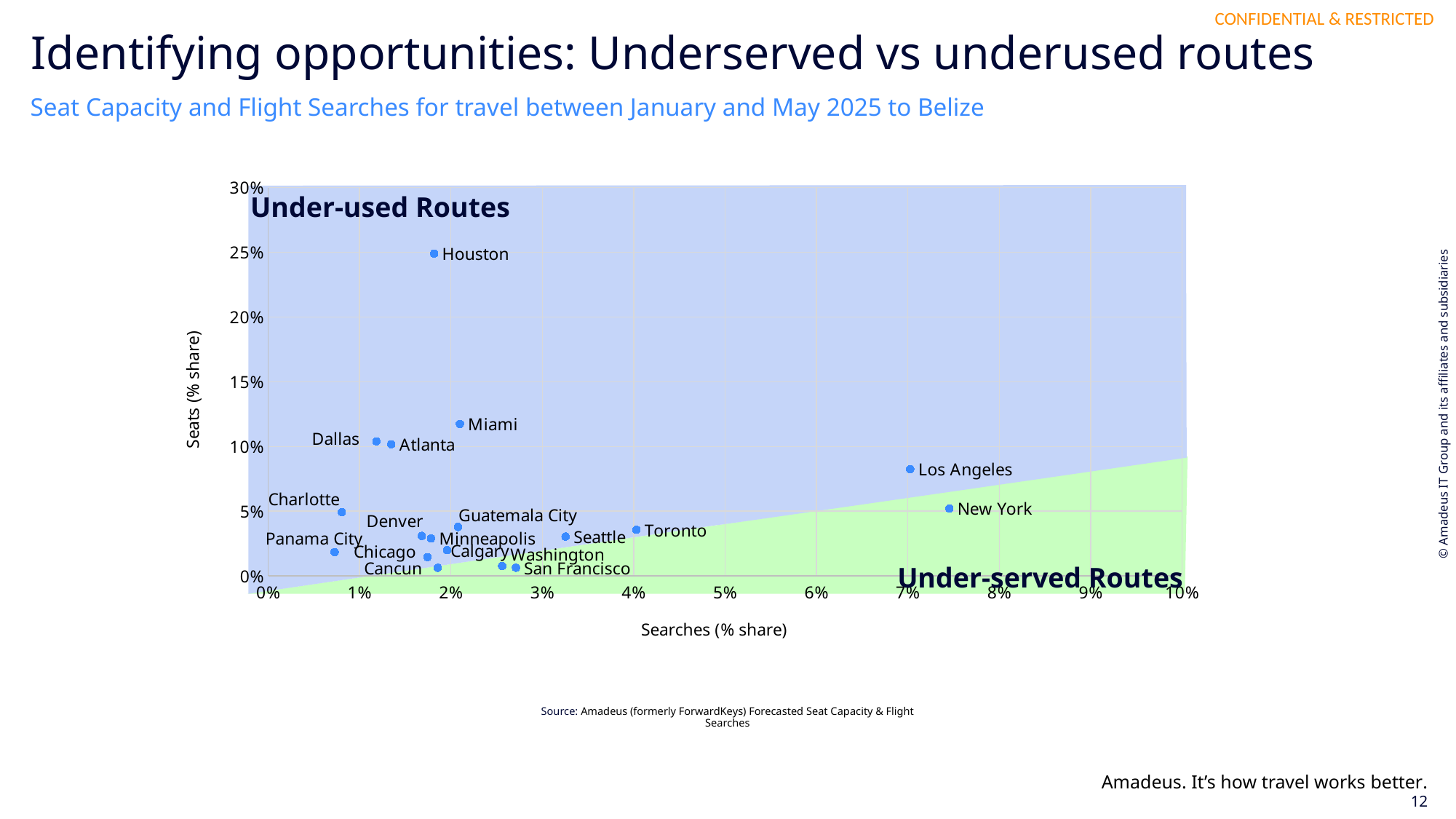
How many cities are plotted on the chart? 18 Is the search share for Los Angeles greater or less than 5%? greater Which city has the highest seat share (% share) on the chart? Houston In which shaded region of the chart does New York fall? Under-served Routes Which city has the highest search share (% share) on the chart? New York What kind of chart is shown on the slide? Scatter chart Which has a higher seat share, Miami or Atlanta? Miami What is the label of the x axis? Searches (% share) Which has a higher search share, Toronto or Seattle? Toronto Is the search share for Charlotte greater or less than 1%? less Is the seat share for New York greater or less than 10%? less